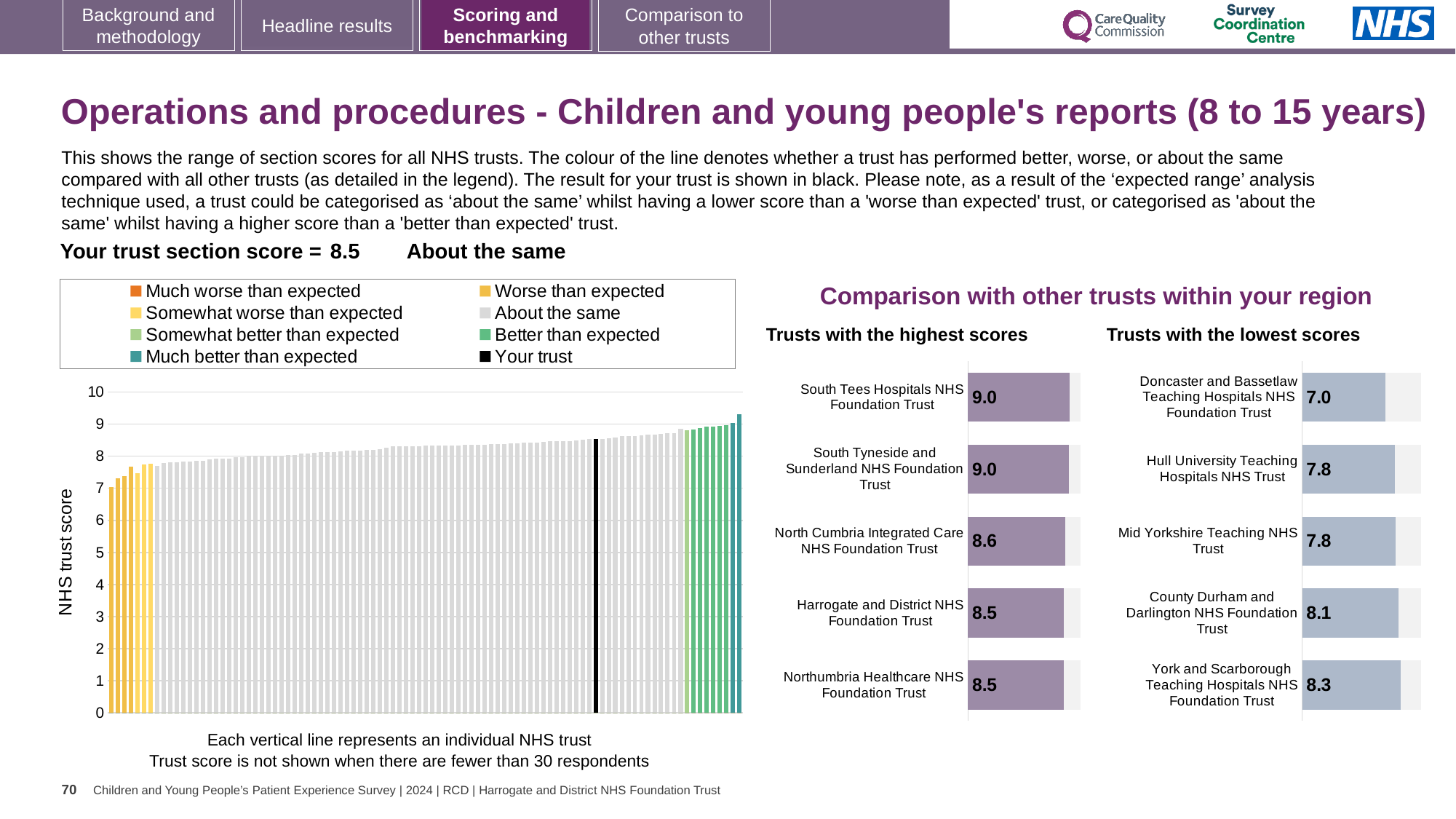
In the 'Trusts with the highest scores' chart, what is the score for North Cumbria Integrated Care NHS Foundation Trust? 8.6 What is your trust's section score shown on the slide? 8.5 What kind of chart is the large chart on the left showing all NHS trusts? Bar chart In the 'Trusts with the highest scores' chart, what is the difference between the scores of South Tees Hospitals NHS Foundation Trust and Harrogate and District NHS Foundation Trust? 0.5 In the 'Trusts with the lowest scores' chart, which trust has the lowest score? Doncaster and Bassetlaw Teaching Hospitals NHS Foundation Trust In the 'Trusts with the lowest scores' chart, what is the score for Doncaster and Bassetlaw Teaching Hospitals NHS Foundation Trust? 7.0 How many entries does the legend above the large chart on the left list? 8 How many trusts are shown in the 'Trusts with the highest scores' chart? 5 In the 'Trusts with the lowest scores' chart, which has the higher score: County Durham and Darlington NHS Foundation Trust or York and Scarborough Teaching Hospitals NHS Foundation Trust? York and Scarborough Teaching Hospitals NHS Foundation Trust In the large chart on the left, do the trust scores rise or fall from left to right? Rise In the 'Trusts with the lowest scores' chart, what is the difference between the scores of York and Scarborough Teaching Hospitals NHS Foundation Trust and Doncaster and Bassetlaw Teaching Hospitals NHS Foundation Trust? 1.3 What is the y-axis title of the large chart on the left? NHS trust score